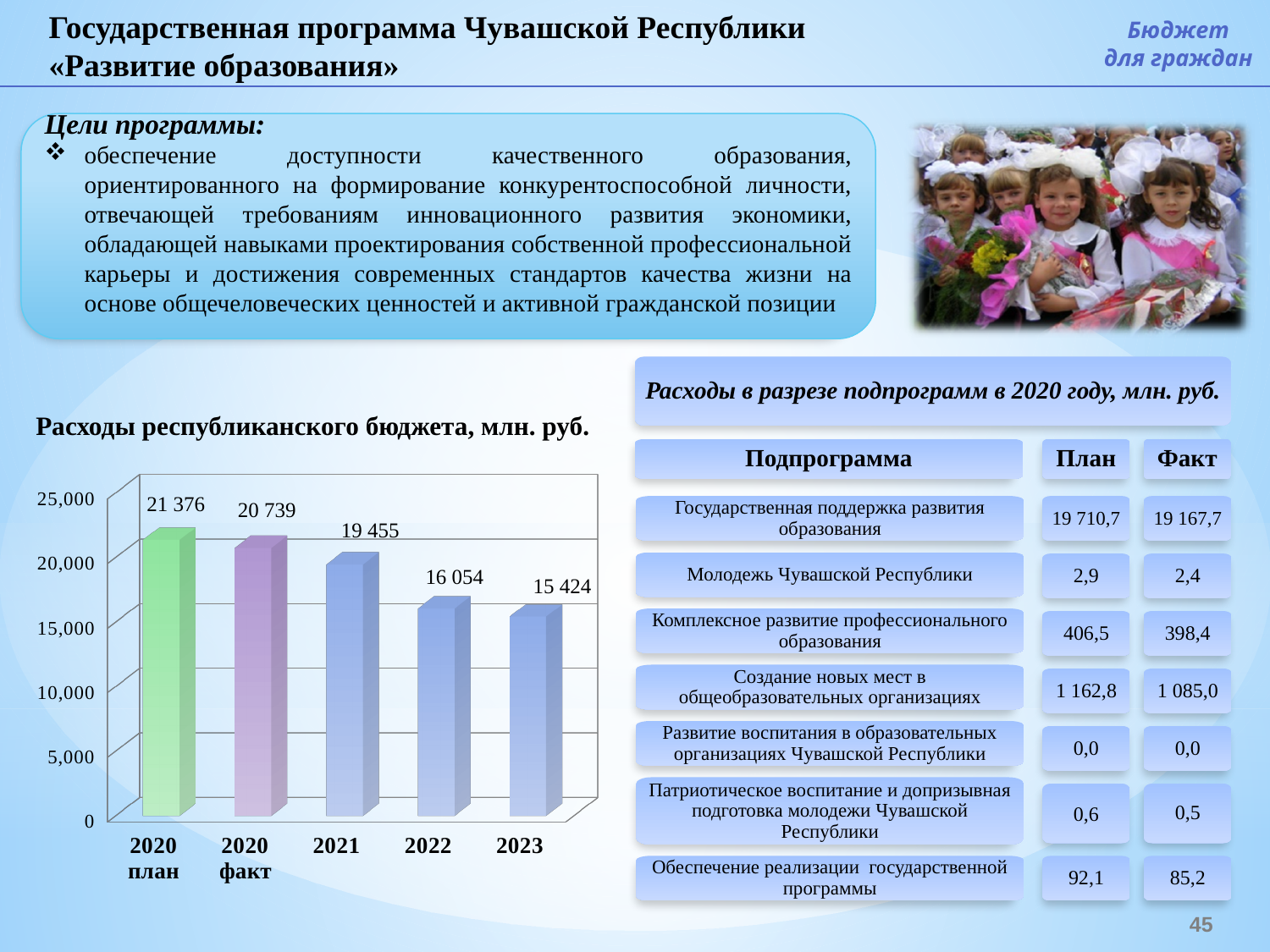
Which category has the highest value in the chart 'Расходы республиканского бюджета, млн. руб.'? 2020 план In the chart 'Расходы республиканского бюджета, млн. руб.', which is larger: the value for 2021 or the value for 2022? 2021 Which category has the lowest value in the chart 'Расходы республиканского бюджета, млн. руб.'? 2023 What is the value for 2023 in the chart 'Расходы республиканского бюджета, млн. руб.'? 15 424 What kind of chart is 'Расходы республиканского бюджета, млн. руб.'? bar chart How many bars are shown in the chart 'Расходы республиканского бюджета, млн. руб.'? 5 What is the value for 2020 факт in the chart 'Расходы республиканского бюджета, млн. руб.'? 20 739 In the chart 'Расходы республиканского бюджета, млн. руб.', is the value for 2022 greater or less than 20,000? less What is the difference between the 2021 and 2022 values in the chart 'Расходы республиканского бюджета, млн. руб.'? 3 401 What is the value for 2020 план in the chart 'Расходы республиканского бюджета, млн. руб.'? 21 376 What is the difference between the 2020 план and 2020 факт values in the chart 'Расходы республиканского бюджета, млн. руб.'? 637 In the chart 'Расходы республиканского бюджета, млн. руб.', do the values rise or fall from 2021 to 2023? fall